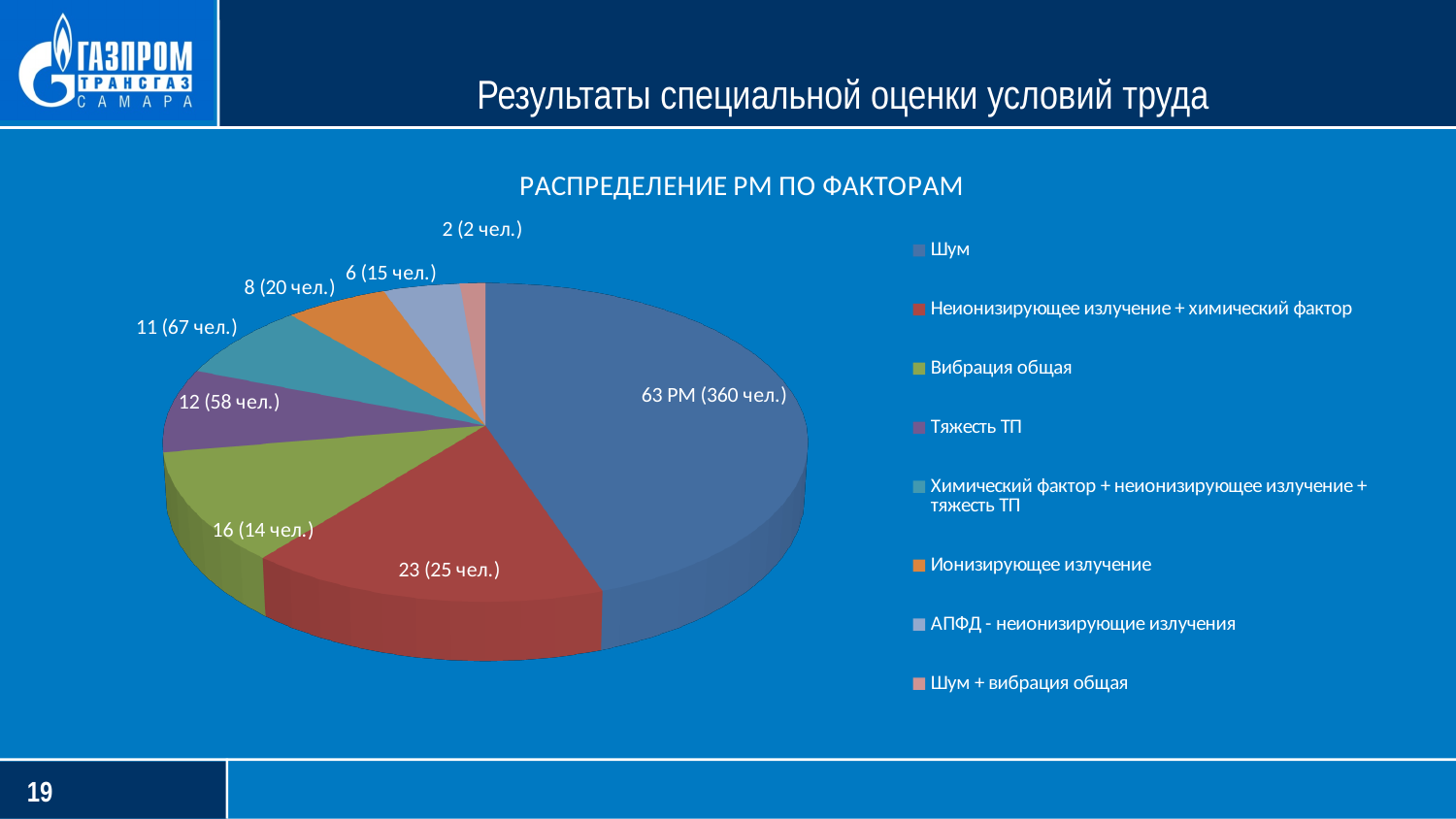
How many slices does the pie chart have? 8 What is the data label on the slice for Тяжесть ТП? 12 (58 чел.) What is the data label on the slice for Неионизирующее излучение + химический фактор? 23 (25 чел.) What is the difference in the number of РМ between Шум (63) and Неионизирующее излучение + химический фактор (23)? 40 How many entries does the legend list? 8 What is the data label on the slice for Ионизирующее излучение? 8 (20 чел.) Which factor has the largest slice of the pie? Шум What kind of chart is shown on the slide? Pie chart What is the title of the chart? РАСПРЕДЕЛЕНИЕ РМ ПО ФАКТОРАМ What is the data label on the slice for Вибрация общая? 16 (14 чел.) Which factor has the smallest slice of the pie? Шум + вибрация общая What is the data label on the slice for Шум? 63 РМ (360 чел.)